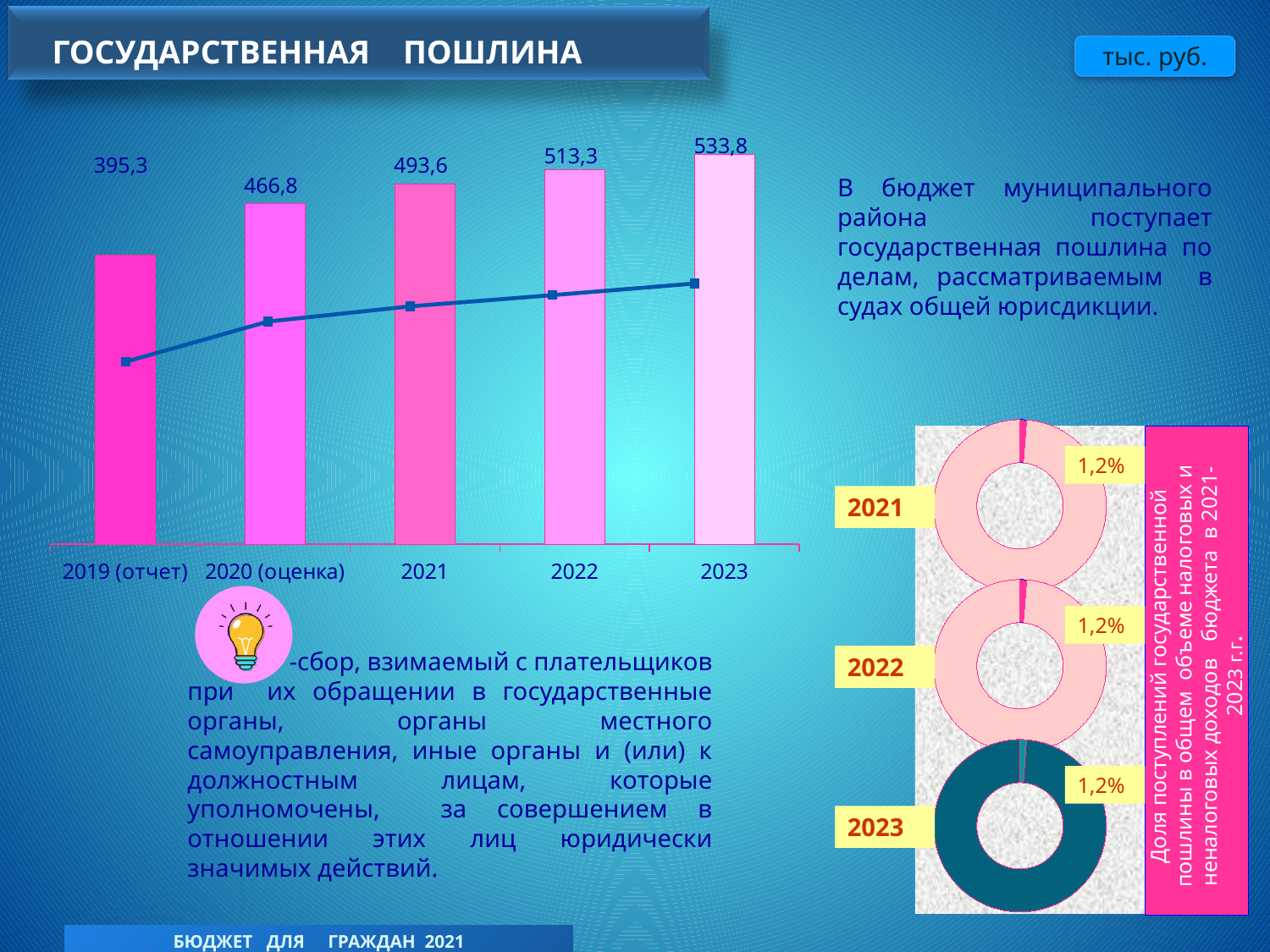
In the bar chart on the left, which year has the lowest value? 2019 (отчет) In the bar chart on the left, what is the value for 2019 (отчет)? 395,3 In the donut charts on the right, what share is shown for 2023? 1,2% In the bar chart on the left, what is the difference between the values for 2022 and 2021? 19,7 In the bar chart on the left, what is the value for 2020 (оценка)? 466,8 In the bar chart on the left, do the values rise or fall from 2019 to 2023? rise In the bar chart on the left, what is the value for 2022? 513,3 What unit of measurement is indicated in the top right corner of the slide? тыс. руб. In the bar chart on the left, what is the difference between the values for 2023 and 2019 (отчет)? 138,5 In the bar chart on the left, which year has the highest value? 2023 How many years (categories) are shown in the bar chart on the left? 5 In the bar chart on the left, which is larger: the value for 2021 or the value for 2020 (оценка)? 2021